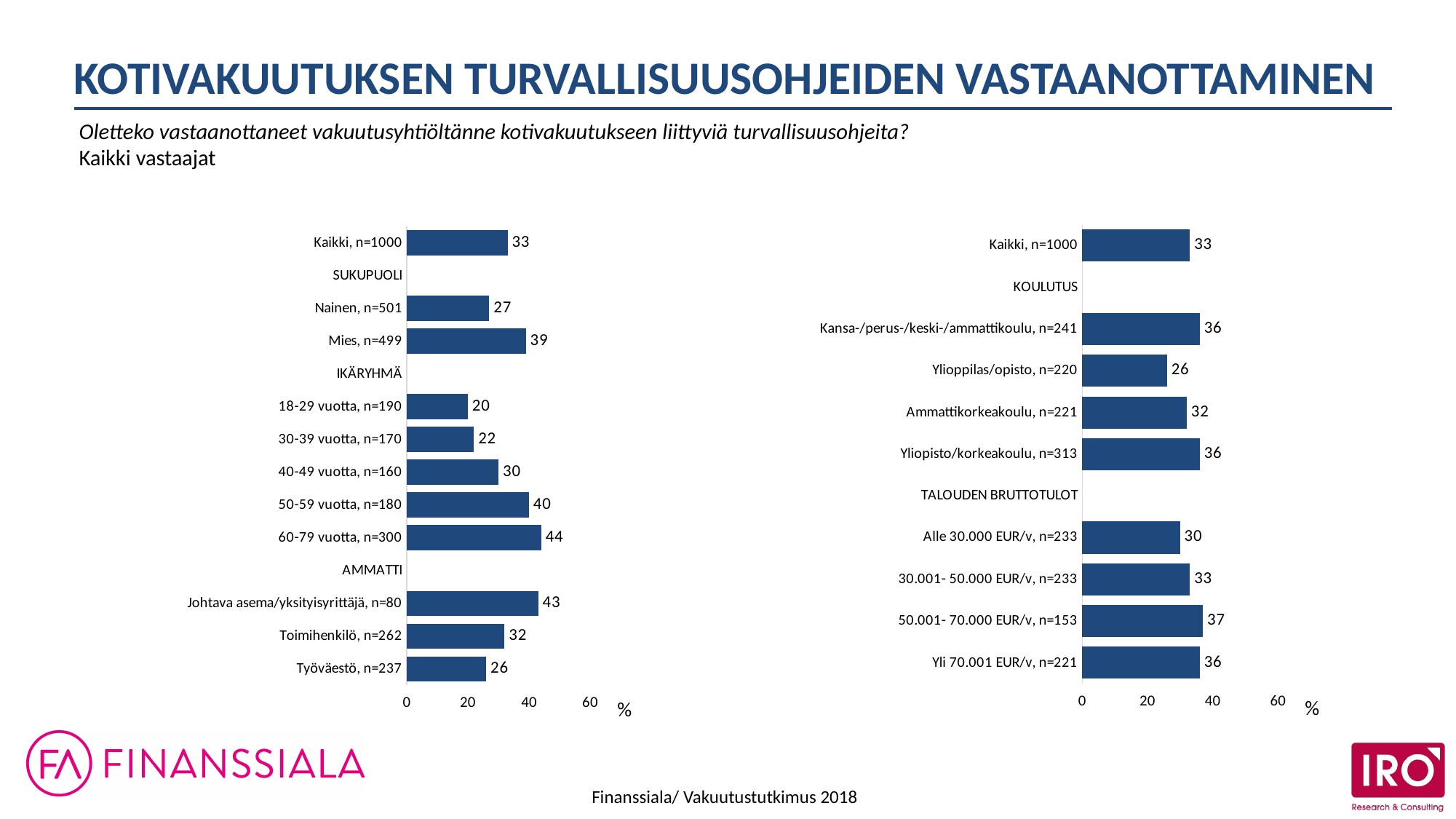
In the right chart, what is the value for Kaikki, n=1000? 33 In the right chart, what is the value for Ylioppilas/opisto, n=220? 26 In the left chart, what is the difference between the values for Mies, n=499 and Nainen, n=501? 12 In the left chart, what is the value for Mies, n=499? 39 What type of chart is shown on the left of the slide? Bar chart In the left chart, which age group (IKÄRYHMÄ) has the lowest value? 18-29 vuotta, n=190 In the left chart, do the values rise or fall across the age groups from 18-29 vuotta to 60-79 vuotta? Rise In the left chart, which is larger: the value for Johtava asema/yksityisyrittäjä, n=80 or Toimihenkilö, n=262? Johtava asema/yksityisyrittäjä, n=80 In the left chart, which age group (IKÄRYHMÄ) has the highest value? 60-79 vuotta, n=300 In the right chart, which education group (KOULUTUS) has the lowest value? Ylioppilas/opisto, n=220 In the right chart, what is the difference between the values for 50.001- 70.000 EUR/v, n=153 and Alle 30.000 EUR/v, n=233? 7 In the right chart, which income group (TALOUDEN BRUTTOTULOT) has the highest value? 50.001- 70.000 EUR/v, n=153